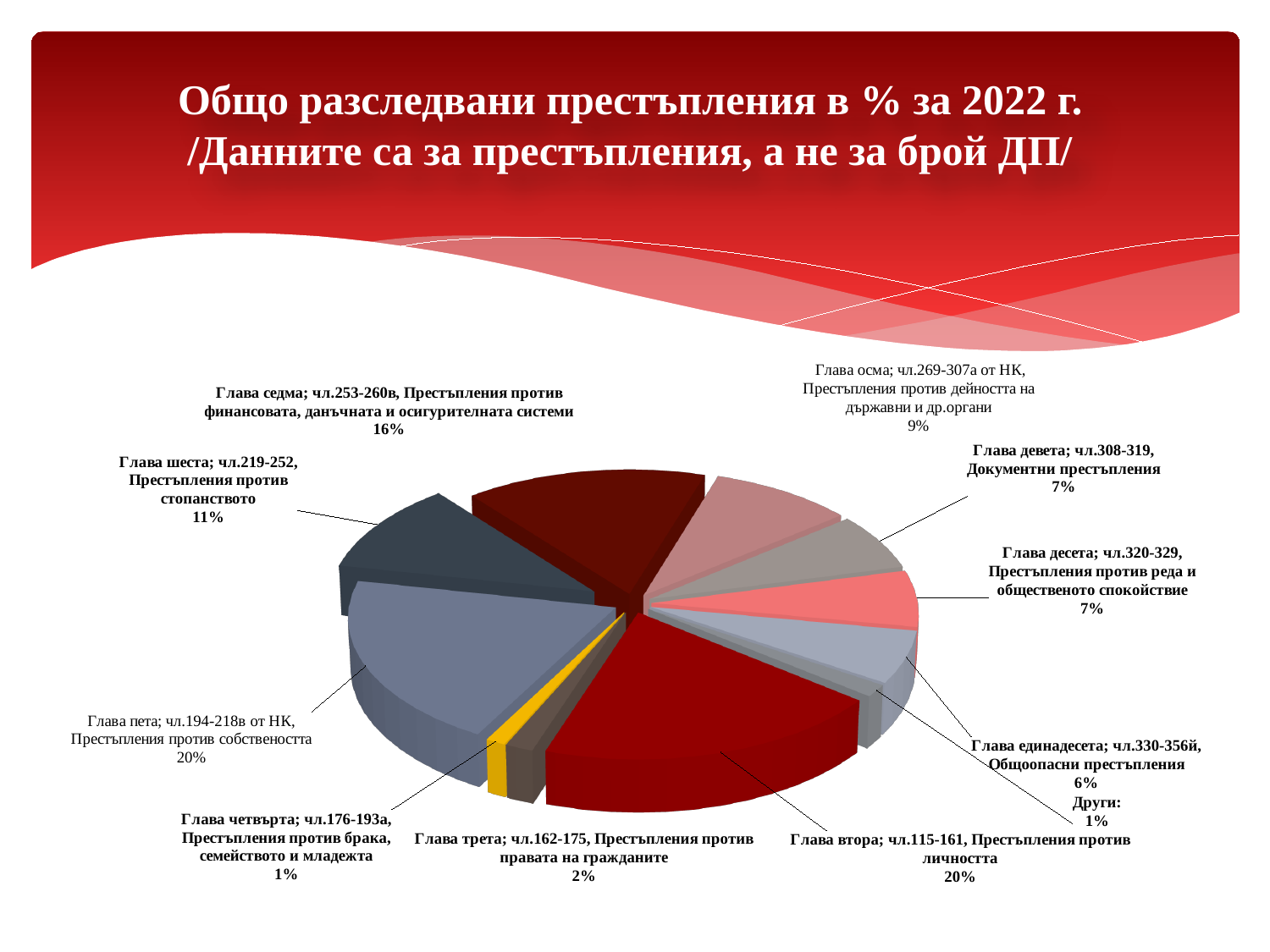
What year does the chart title say the data refers to? 2022 What percentage is shown for Глава пета; чл.194-218в от НК, Престъпления против собствеността? 20% What percentage is shown for Глава трета; чл.162-175, Престъпления против правата на гражданите? 2% What is the difference in percentage points between Глава втора (Престъпления против личността) and Глава седма (Престъпления против финансовата, данъчната и осигурителната системи)? 4 percentage points How many slices does the pie chart have? 11 What percentage is shown for Глава единадесета; чл.330-356й, Общоопасни престъпления? 6% What percentage is shown for Глава шеста; чл.219-252, Престъпления против стопанството? 11% Which is larger: the share for Глава шеста (Престъпления против стопанството) or the share for Глава девета (Документни престъпления)? Глава шеста (Престъпления против стопанството) What percentage is shown for Глава осма; чл.269-307а от НК, Престъпления против дейността на държавни и др.органи? 9% What percentage is shown for Глава седма; чл.253-260в, Престъпления против финансовата, данъчната и осигурителната системи? 16% What kind of chart is shown on the slide? Pie chart What is the combined share of Глава девета (Документни престъпления) and Глава десета (Престъпления против реда и общественото спокойствие)? 14%